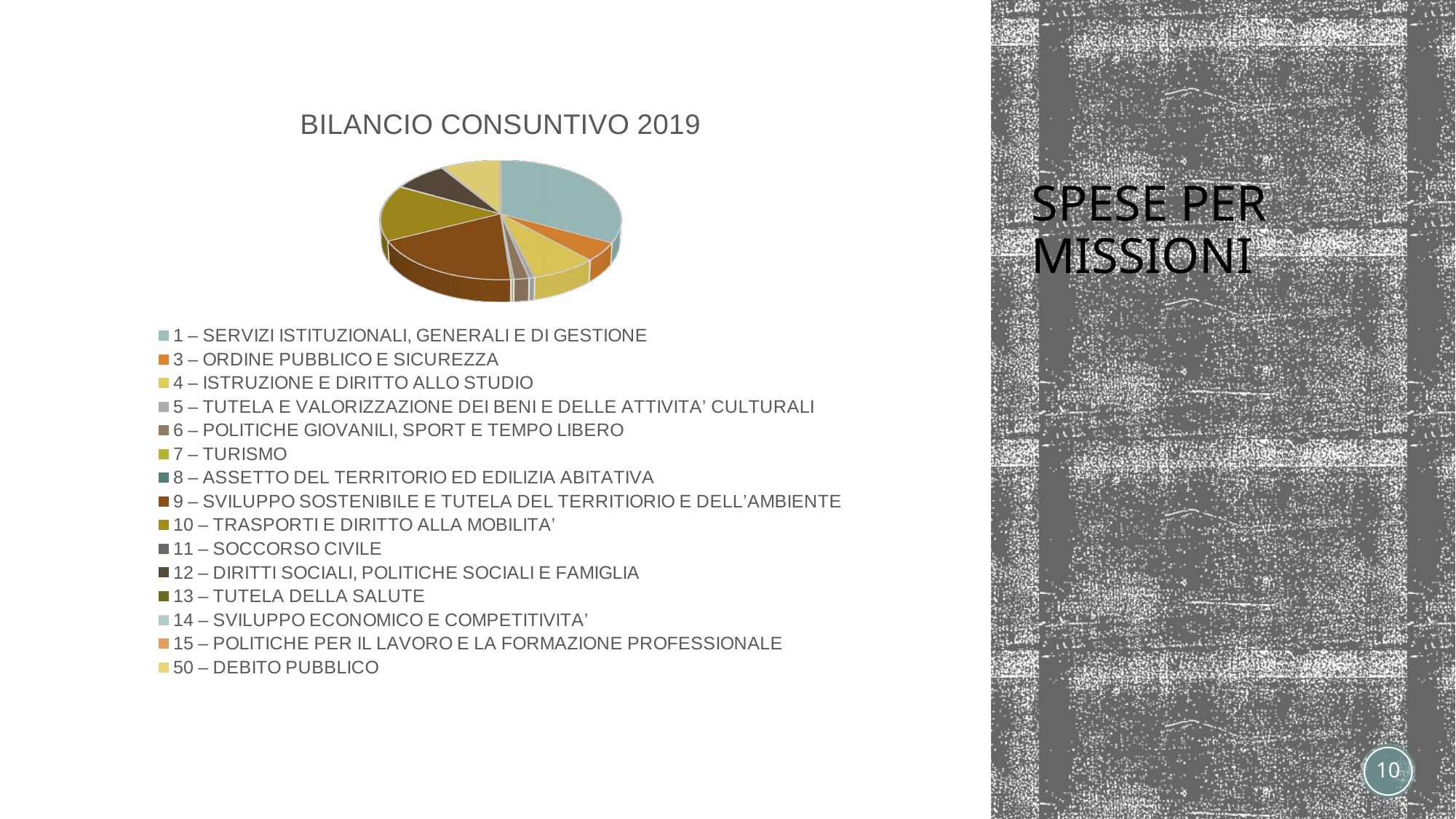
What is the last category listed in the chart's legend? 50 – DEBITO PUBBLICO Which slice is larger: 9 – SVILUPPO SOSTENIBILE E TUTELA DEL TERRITIORIO E DELL'AMBIENTE or 7 – TURISMO? 9 – SVILUPPO SOSTENIBILE E TUTELA DEL TERRITIORIO E DELL'AMBIENTE Which slice is larger: 9 – SVILUPPO SOSTENIBILE E TUTELA DEL TERRITIORIO E DELL'AMBIENTE or 6 – POLITICHE GIOVANILI, SPORT E TEMPO LIBERO? 9 – SVILUPPO SOSTENIBILE E TUTELA DEL TERRITIORIO E DELL'AMBIENTE Which category has the largest slice of the pie? 1 – SERVIZI ISTITUZIONALI, GENERALI E DI GESTIONE Which slice is larger: 10 – TRASPORTI E DIRITTO ALLA MOBILITA' or 5 – TUTELA E VALORIZZAZIONE DEI BENI E DELLE ATTIVITA' CULTURALI? 10 – TRASPORTI E DIRITTO ALLA MOBILITA' What is the title of the chart? BILANCIO CONSUNTIVO 2019 What kind of chart is shown on the slide? pie chart How many categories does the chart's legend list? 15